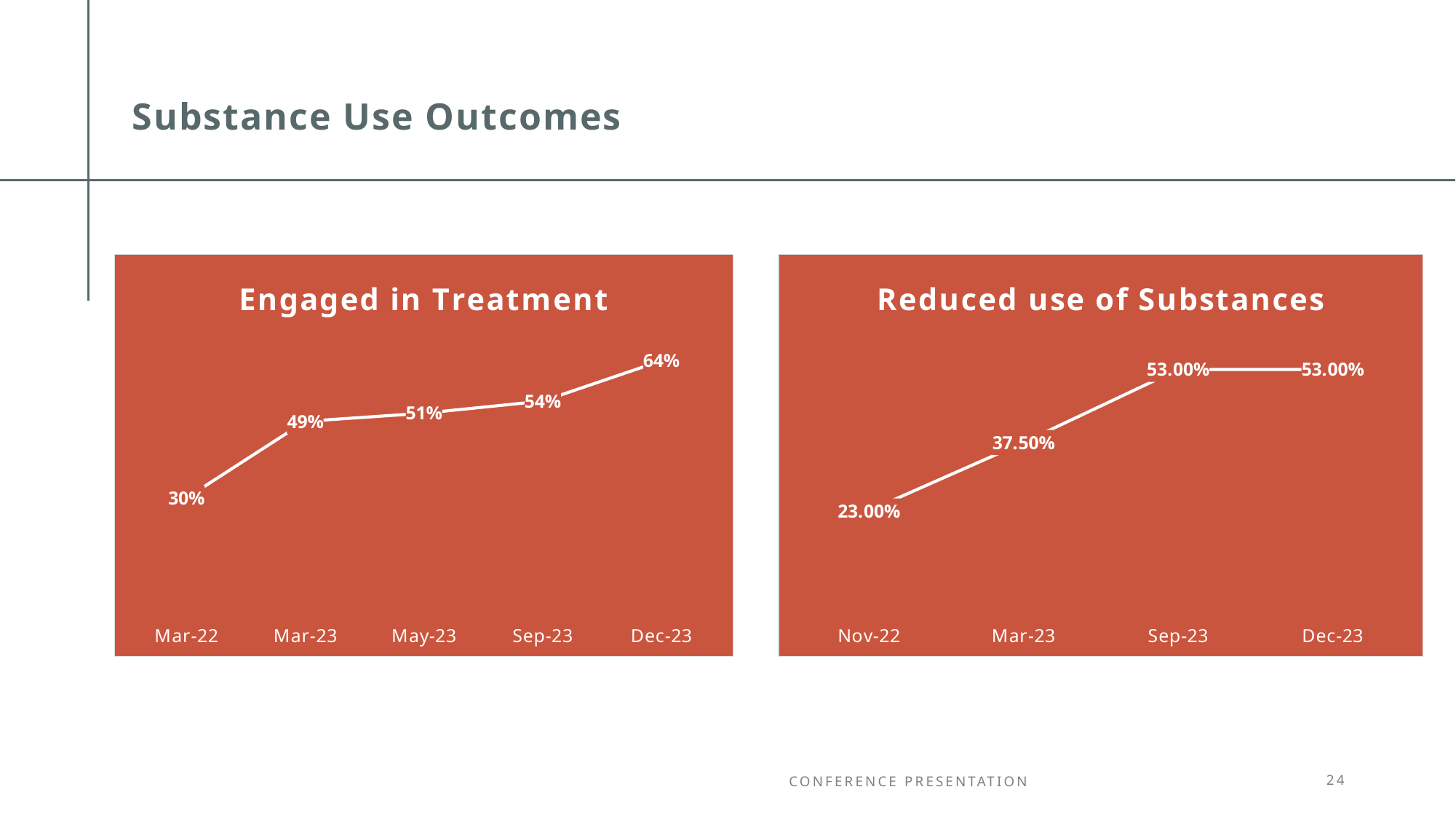
In the 'Reduced use of Substances' chart, what is the value for Nov-22? 23.00% In the 'Reduced use of Substances' chart, what is the difference between the Sep-23 and Mar-23 values? 15.50% In the 'Engaged in Treatment' chart, what is the value for Mar-22? 30% In the 'Engaged in Treatment' chart, which date has the highest value? Dec-23 In the 'Engaged in Treatment' chart, what is the value for Sep-23? 54% In the 'Reduced use of Substances' chart, how many dates are shown on the x axis? 4 In the 'Engaged in Treatment' chart, what is the difference between the Dec-23 and Mar-22 values? 34% In the 'Engaged in Treatment' chart, how many data points are plotted? 5 In the 'Reduced use of Substances' chart, which date has the lowest value? Nov-22 What kind of chart is the 'Reduced use of Substances' chart? line chart In the 'Reduced use of Substances' chart, what is the value for Mar-23? 37.50% In the 'Engaged in Treatment' chart, do the values rise or fall from Mar-22 to Dec-23? rise